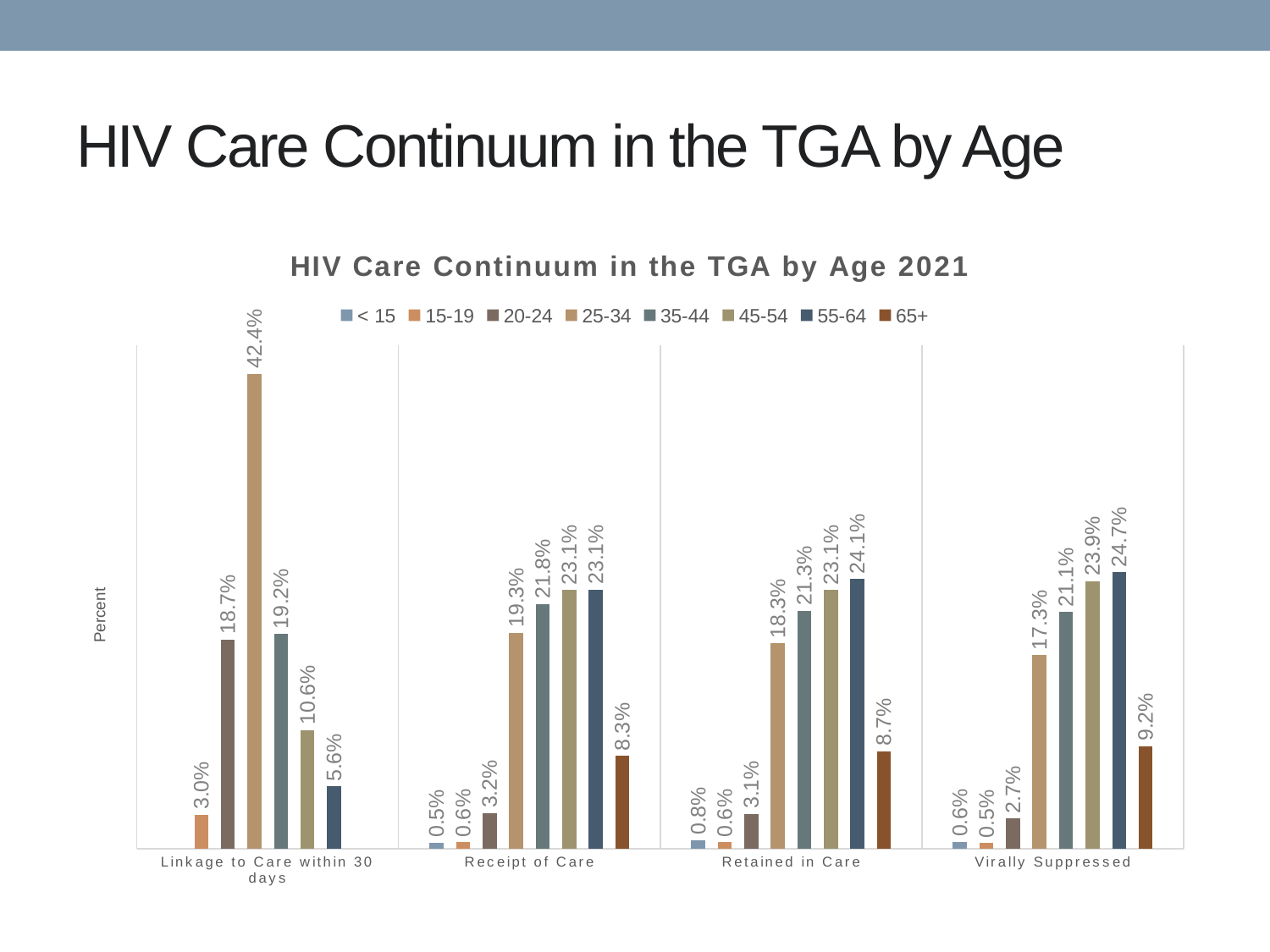
What is the title of the chart? HIV Care Continuum in the TGA by Age 2021 How many care continuum categories are shown on the x axis? 4 Which age group has the highest value in Virally Suppressed? 55-64 What is the value for the 20-24 age group in Retained in Care? 3.1% What is the value for the 65+ age group in Virally Suppressed? 9.2% Which is larger in Receipt of Care: the value for 25-34 or the value for 65+? 25-34 What kind of chart is shown on the slide? Bar chart What is the value for the 35-44 age group in Receipt of Care? 21.8% What is the value for the 25-34 age group in Linkage to Care within 30 days? 42.4% Which age group has the lowest value in Retained in Care? 15-19 How many age groups does the legend list? 8 What is the difference between the 55-64 and 65+ values in Retained in Care? 15.4%